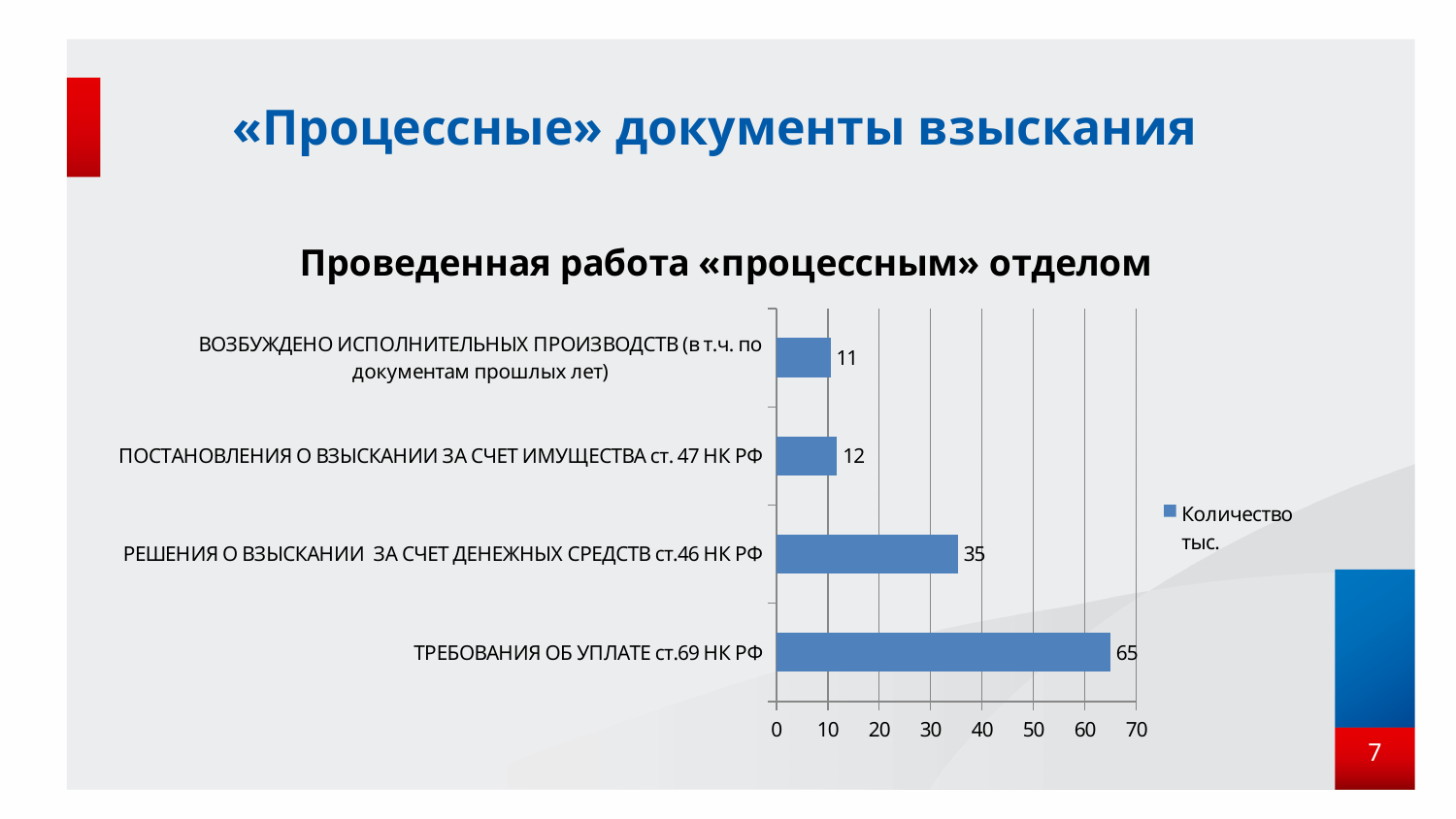
What is the value for РЕШЕНИЯ О ВЗЫСКАНИИ ЗА СЧЕТ ДЕНЕЖНЫХ СРЕДСТВ ст.46 НК РФ? 35 What is the difference between the values for ТРЕБОВАНИЯ ОБ УПЛАТЕ ст.69 НК РФ and РЕШЕНИЯ О ВЗЫСКАНИИ ЗА СЧЕТ ДЕНЕЖНЫХ СРЕДСТВ ст.46 НК РФ? 30 What is the value for ПОСТАНОВЛЕНИЯ О ВЗЫСКАНИИ ЗА СЧЕТ ИМУЩЕСТВА ст. 47 НК РФ? 12 How many categories are shown in the chart? 4 What is the value for ТРЕБОВАНИЯ ОБ УПЛАТЕ ст.69 НК РФ? 65 Which category has the highest value? ТРЕБОВАНИЯ ОБ УПЛАТЕ ст.69 НК РФ What kind of chart is shown on the slide? bar chart Is the value for ТРЕБОВАНИЯ ОБ УПЛАТЕ ст.69 НК РФ greater or less than 60? greater What is the title of the chart? Проведенная работа «процессным» отделом Which is larger: the value for ПОСТАНОВЛЕНИЯ О ВЗЫСКАНИИ ЗА СЧЕТ ИМУЩЕСТВА ст. 47 НК РФ or the value for РЕШЕНИЯ О ВЗЫСКАНИИ ЗА СЧЕТ ДЕНЕЖНЫХ СРЕДСТВ ст.46 НК РФ? РЕШЕНИЯ О ВЗЫСКАНИИ ЗА СЧЕТ ДЕНЕЖНЫХ СРЕДСТВ ст.46 НК РФ Which category has the lowest value? ВОЗБУЖДЕНО ИСПОЛНИТЕЛЬНЫХ ПРОИЗВОДСТВ (в т.ч. по документам прошлых лет) What is the value for ВОЗБУЖДЕНО ИСПОЛНИТЕЛЬНЫХ ПРОИЗВОДСТВ (в т.ч. по документам прошлых лет)? 11